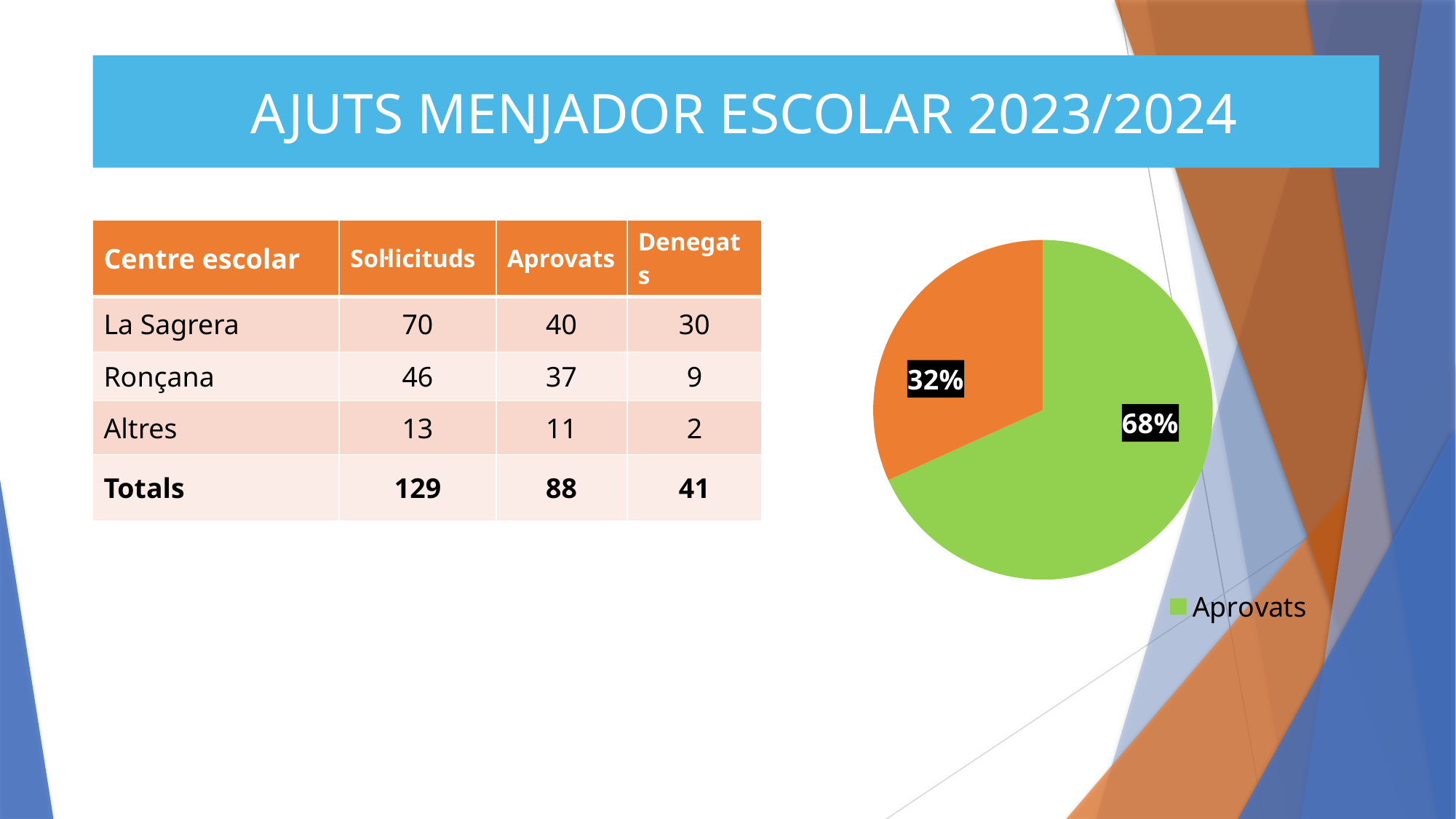
Is the share of the Aprovats slice greater or less than 50%? greater What percentage is shown on the orange slice of the pie chart? 32% Which slice of the pie chart is the smallest? the orange slice (32%) What colour is the Aprovats slice in the pie chart? green How many slices does the pie chart have? 2 What kind of chart is shown on the slide? pie chart What legend entry is shown below the pie chart? Aprovats Which slice of the pie chart is the largest? Aprovats (68%) What is the difference in percentage points between the 68% slice and the 32% slice? 36 percentage points What share of the pie does the Aprovats slice represent? 68% Which is larger in the pie chart, the green slice or the orange slice? the green slice